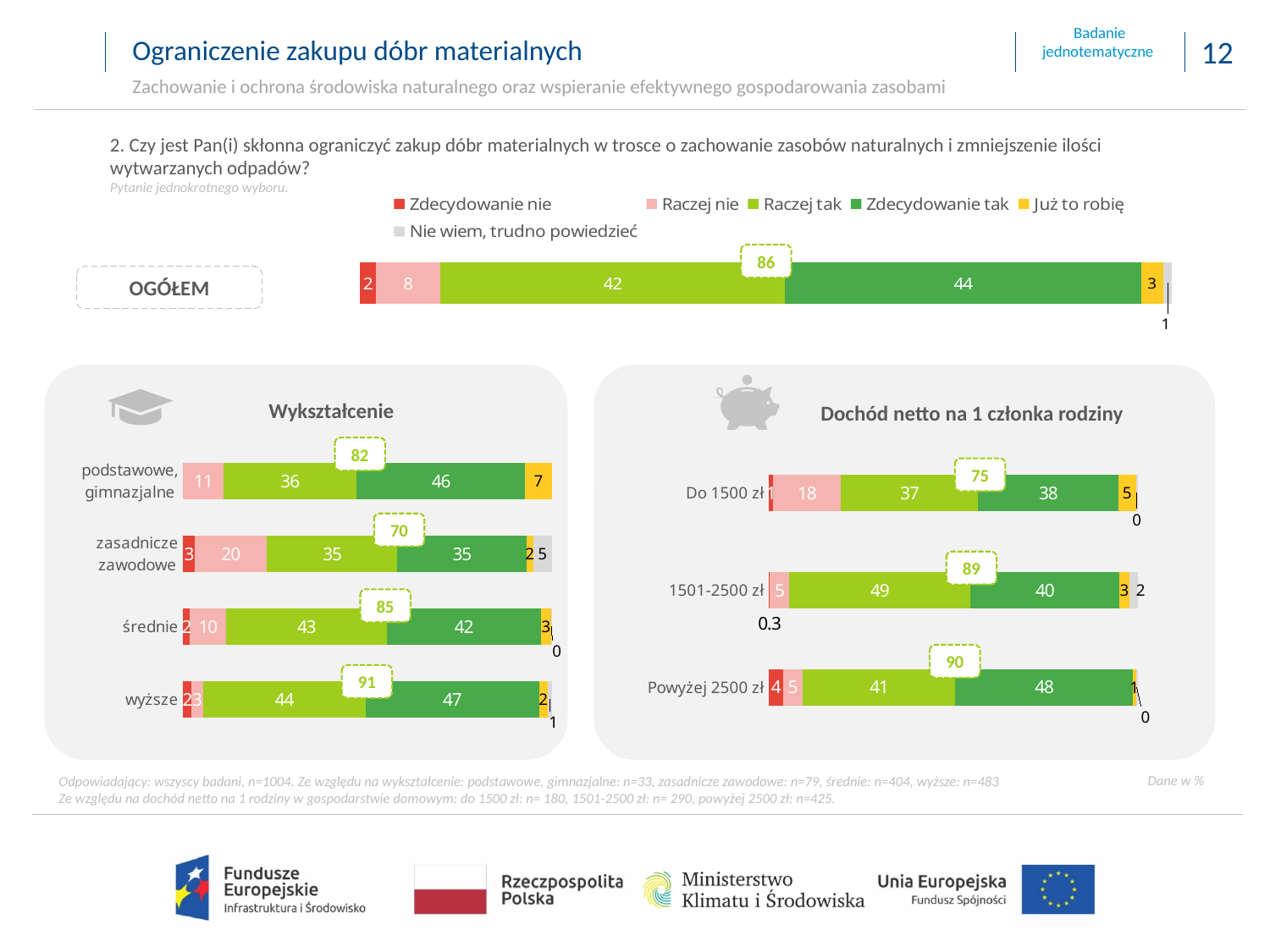
In the Dochód netto na 1 członka rodziny chart, what is the 'Raczej tak' value for '1501-2500 zł'? 49 In the Wykształcenie chart, what is the 'Zdecydowanie tak' value for 'wyższe'? 47 In the Dochód netto na 1 członka rodziny chart, which income group has the lowest 'Zdecydowanie tak' value? Do 1500 zł In the OGÓŁEM chart, what is the difference between 'Zdecydowanie tak' and 'Raczej tak'? 2 In the Wykształcenie chart, what is the 'Już to robię' value for 'podstawowe, gimnazjalne'? 7 In the OGÓŁEM chart, what is the value for 'Zdecydowanie tak'? 44 In the Wykształcenie chart, how many education categories are shown? 4 What type of chart is used on this slide? Stacked bar chart How many series does the legend list? 6 In the Wykształcenie chart, which education group has the highest 'Raczej nie' value? zasadnicze zawodowe In the Dochód netto na 1 członka rodziny chart, is the 'Raczej nie' value larger for 'Do 1500 zł' or for 'Powyżej 2500 zł'? Do 1500 zł In the OGÓŁEM chart, what is the value for 'Raczej nie'? 8